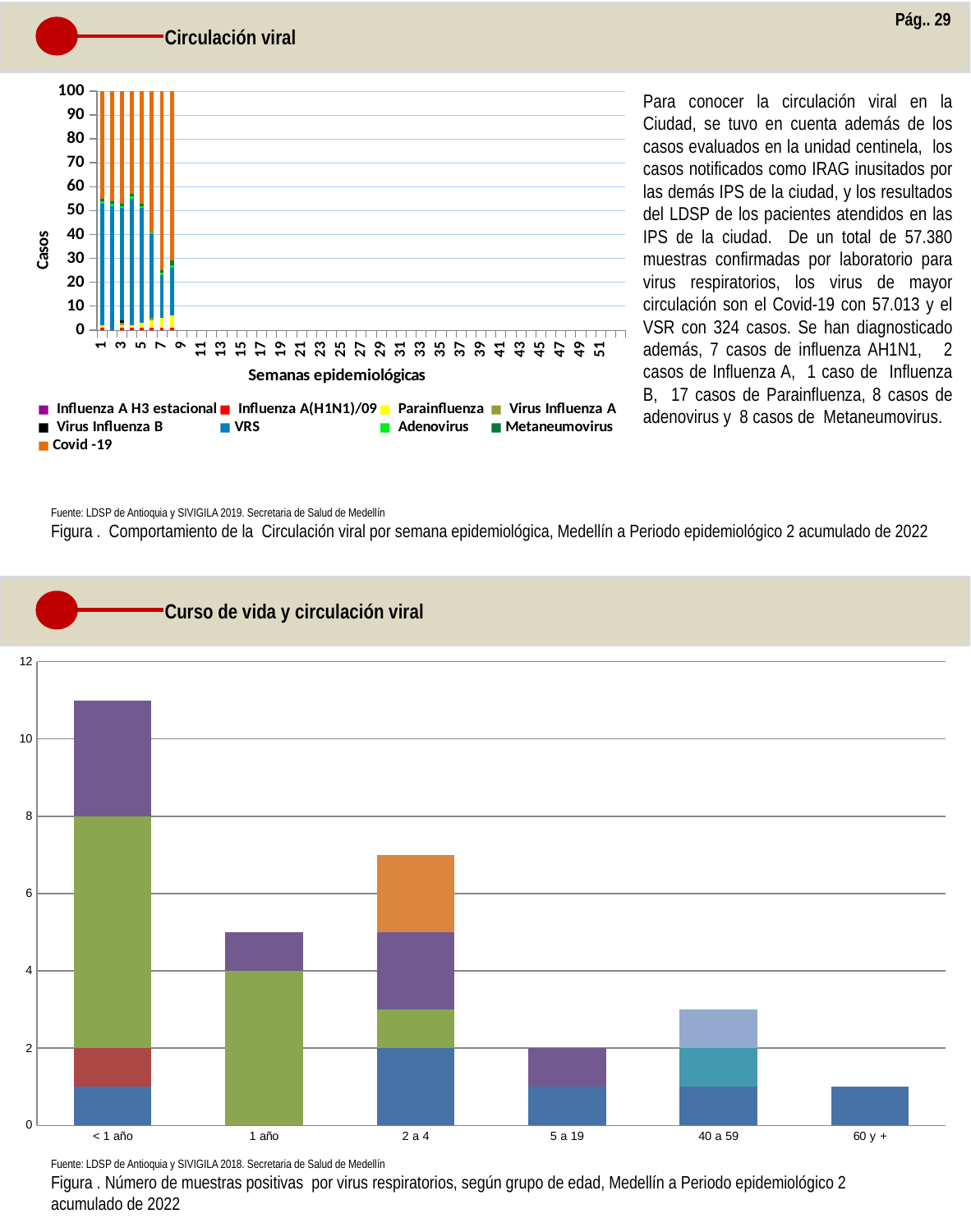
In the bottom chart, is the total for the 2 a 4 bar greater or less than 6? greater In the bottom chart, which age group has the shortest stacked bar? 60 y + In the bottom chart, how many age-group categories are shown on the x axis? 6 In the bottom chart, which stacked bar is taller, 2 a 4 or 1 año? 2 a 4 What kind of chart is the bottom chart (Curso de vida y circulación viral)? Stacked bar chart What is the x-axis title of the top chart (Circulación viral)? Semanas epidemiológicas In the bottom chart, is the total for the < 1 año bar greater or less than 10? greater How many series does the legend of the top chart (Circulación viral) list? 9 In the bottom chart, is the total for the 1 año bar greater or less than 4? greater In the bottom chart, what is the total height of the 5 a 19 bar? 2 In the bottom chart, which age group has the tallest stacked bar? < 1 año